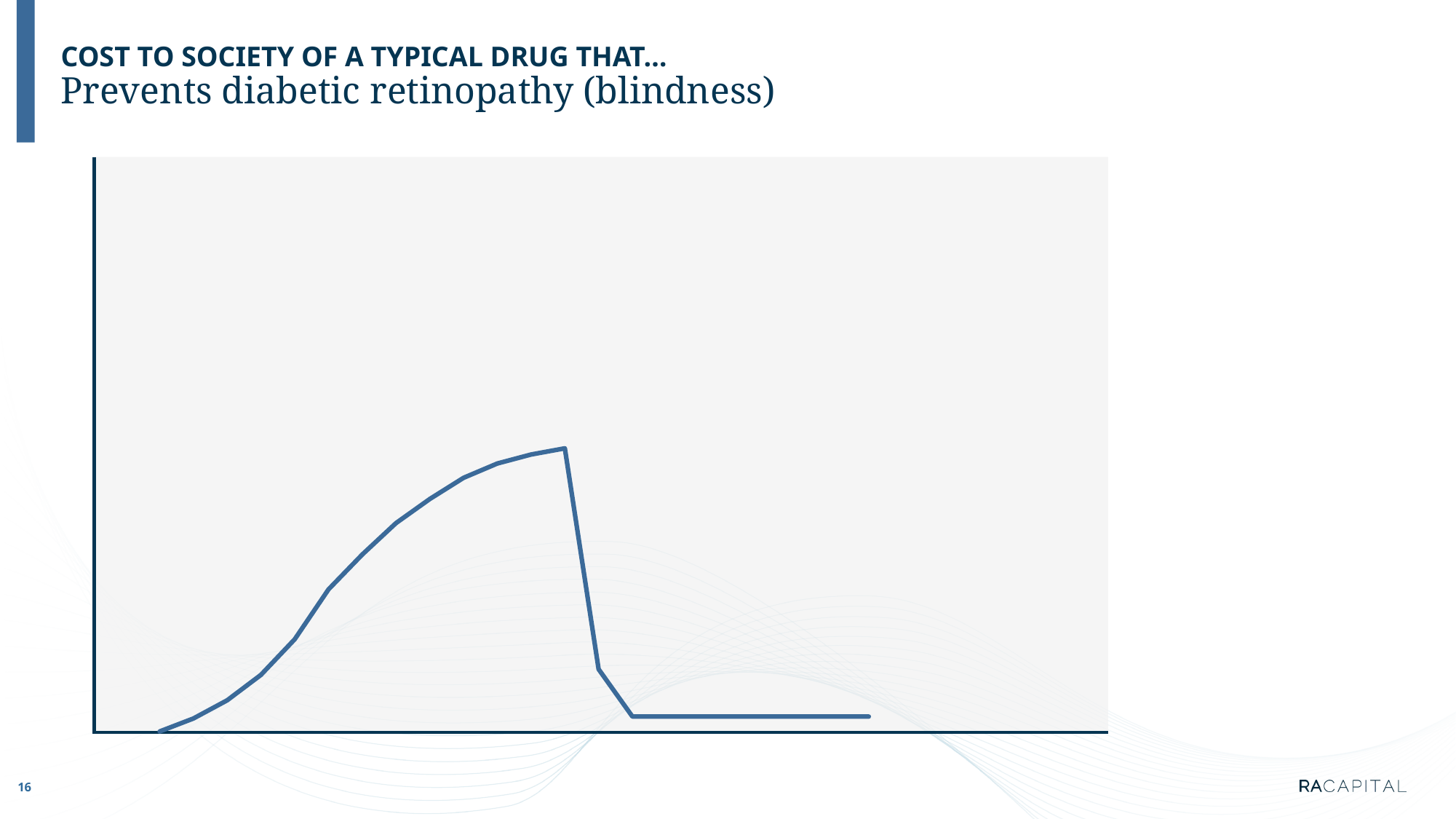
What is the subtitle of the chart on the slide? Prevents diabetic retinopathy (blindness) Toward the right end of the chart, is the line rising, falling, or flat? flat Does the line rise or fall from the left edge up to its peak? rise What kind of chart is shown on the slide? line chart How many lines are plotted on the chart? 1 Is the drop after the peak gradual or sharp? sharp